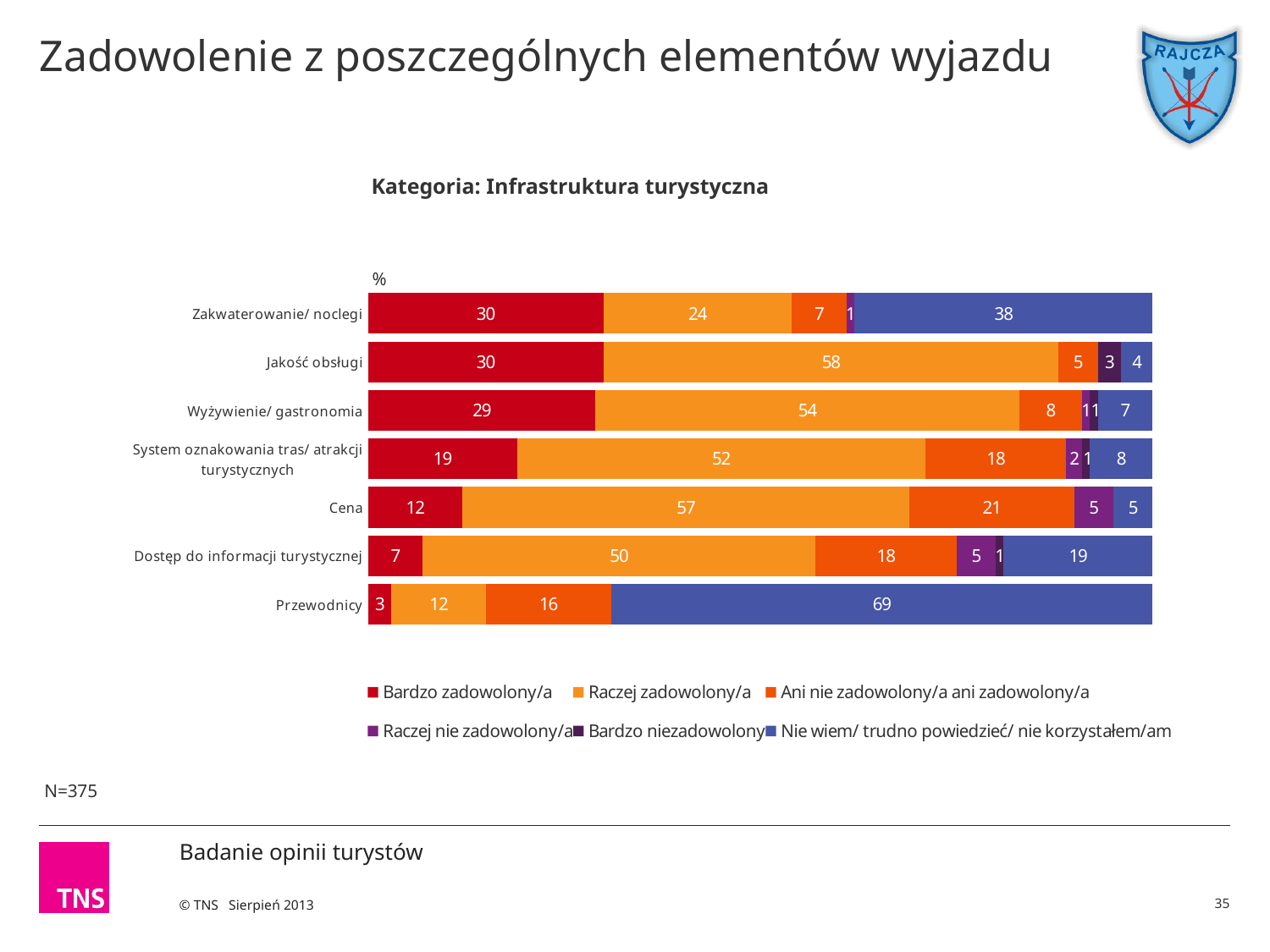
What is the value for 'Nie wiem/ trudno powiedzieć/ nie korzystałem/am' for 'Przewodnicy'? 69 Which category has the highest value for 'Raczej zadowolony/a'? Jakość obsługi What category heading is shown above the chart? Kategoria: Infrastruktura turystyczna What is the value for 'Ani nie zadowolony/a ani zadowolony/a' for 'System oznakowania tras/ atrakcji turystycznych'? 18 Which category has the lowest value for 'Bardzo zadowolony/a'? Przewodnicy What kind of chart is shown on the slide? Stacked bar chart How many categories (elements of the trip) are plotted on the chart? 7 Which is larger: the 'Nie wiem/ trudno powiedzieć/ nie korzystałem/am' value for 'Zakwaterowanie/ noclegi' or for 'Dostęp do informacji turystycznej'? Zakwaterowanie/ noclegi What is the difference between the 'Raczej zadowolony/a' value and the 'Ani nie zadowolony/a ani zadowolony/a' value for 'Cena'? 36 How many series does the legend list? 6 What is the value for 'Bardzo zadowolony/a' for 'Cena'? 12 What is the value for 'Raczej zadowolony/a' for 'Jakość obsługi'? 58